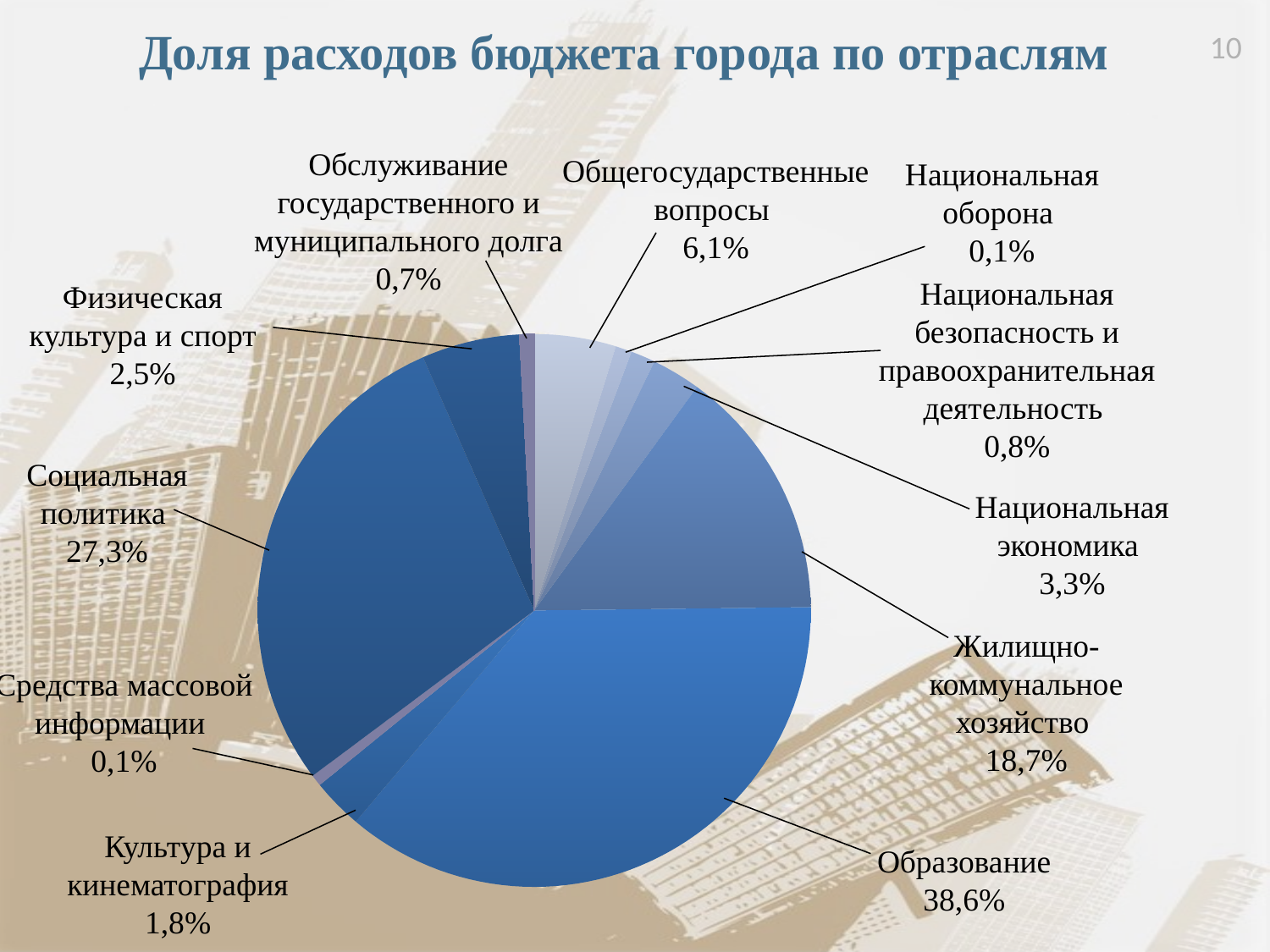
What is the difference in percentage points between Образование and Социальная политика? 11,3% What type of chart is shown on the slide? pie chart What is the title of the chart? Доля расходов бюджета города по отраслям Which sector has the largest share of budget expenditures? Образование What share is shown for Жилищно-коммунальное хозяйство? 18,7% What share is shown for Обслуживание государственного и муниципального долга? 0,7% What share is shown for Социальная политика? 27,3% Which has a larger share: Социальная политика or Жилищно-коммунальное хозяйство? Социальная политика What is the difference in percentage points between Общегосударственные вопросы and Физическая культура и спорт? 3,6% What share of the city budget expenditures goes to Образование? 38,6% How many sectors (slices) are shown in the pie chart? 11 What share is shown for Национальная экономика? 3,3%